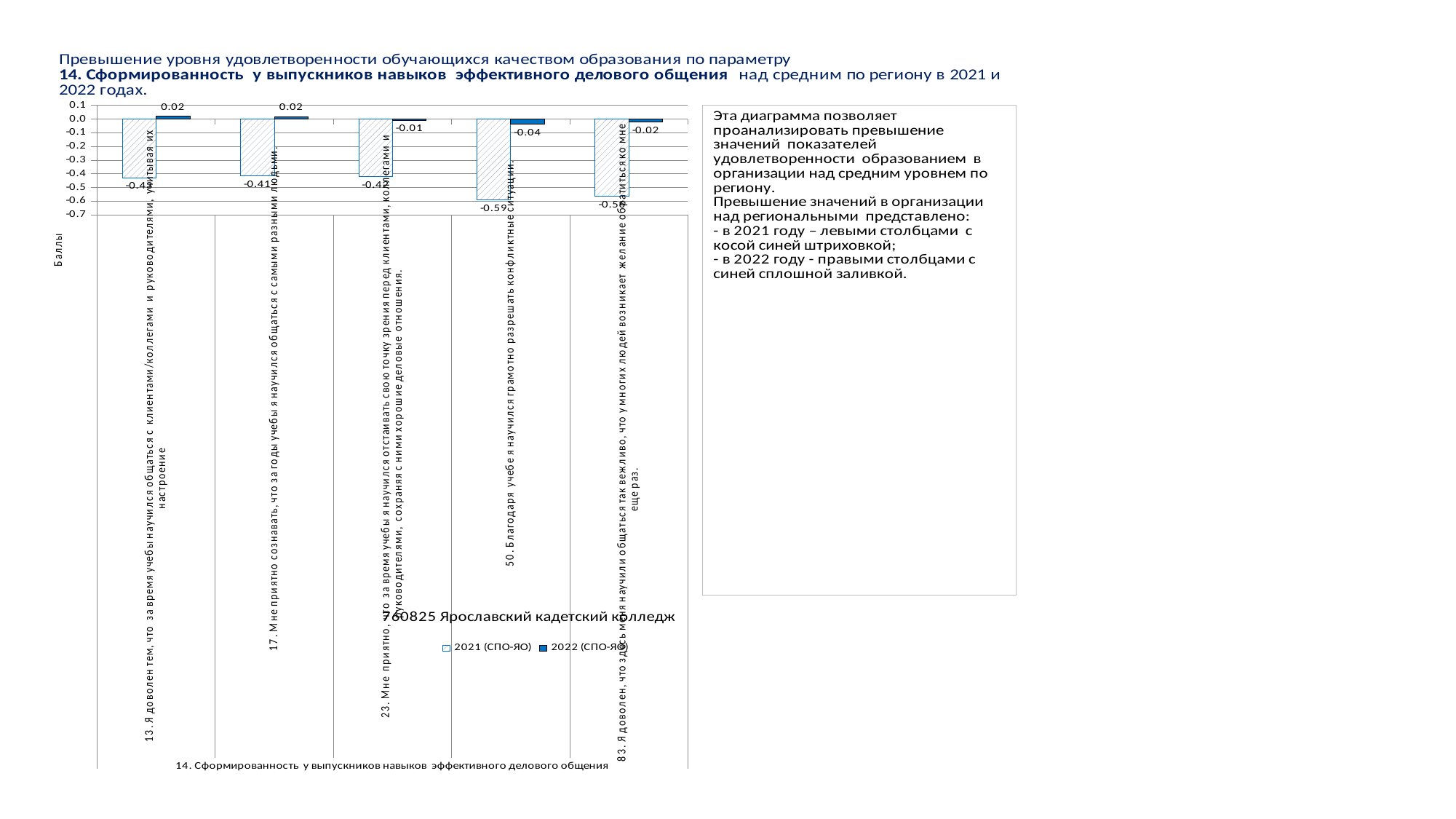
How many series does the chart legend list? 2 What is the difference between the 2022 and 2021 values for question 50? 0.55 What is the 2021 (СПО-ЯО) value for question 17 (Мне приятно сознавать, что за годы учебы я научился общаться с самыми разными людьми)? -0.41 What type of chart is shown on the slide? bar chart Which question has the lowest 2021 (СПО-ЯО) value? 50. Благодаря учебе я научился грамотно разрешать конфликтные ситуации How many categories (questions) are plotted on the chart? 5 Is the 2021 (СПО-ЯО) value for question 83 greater or less than -0.5? less What is the 2021 (СПО-ЯО) value for question 50 (Благодаря учебе я научился грамотно разрешать конфликтные ситуации)? -0.59 What is the 2022 (СПО-ЯО) value for question 23 (Мне приятно, что за время учебы я научился отстаивать свою точку зрения)? -0.01 Which question has the lowest 2022 (СПО-ЯО) value? 50. Благодаря учебе я научился грамотно разрешать конфликтные ситуации What is the 2022 (СПО-ЯО) value for question 50 (Благодаря учебе я научился грамотно разрешать конфликтные ситуации)? -0.04